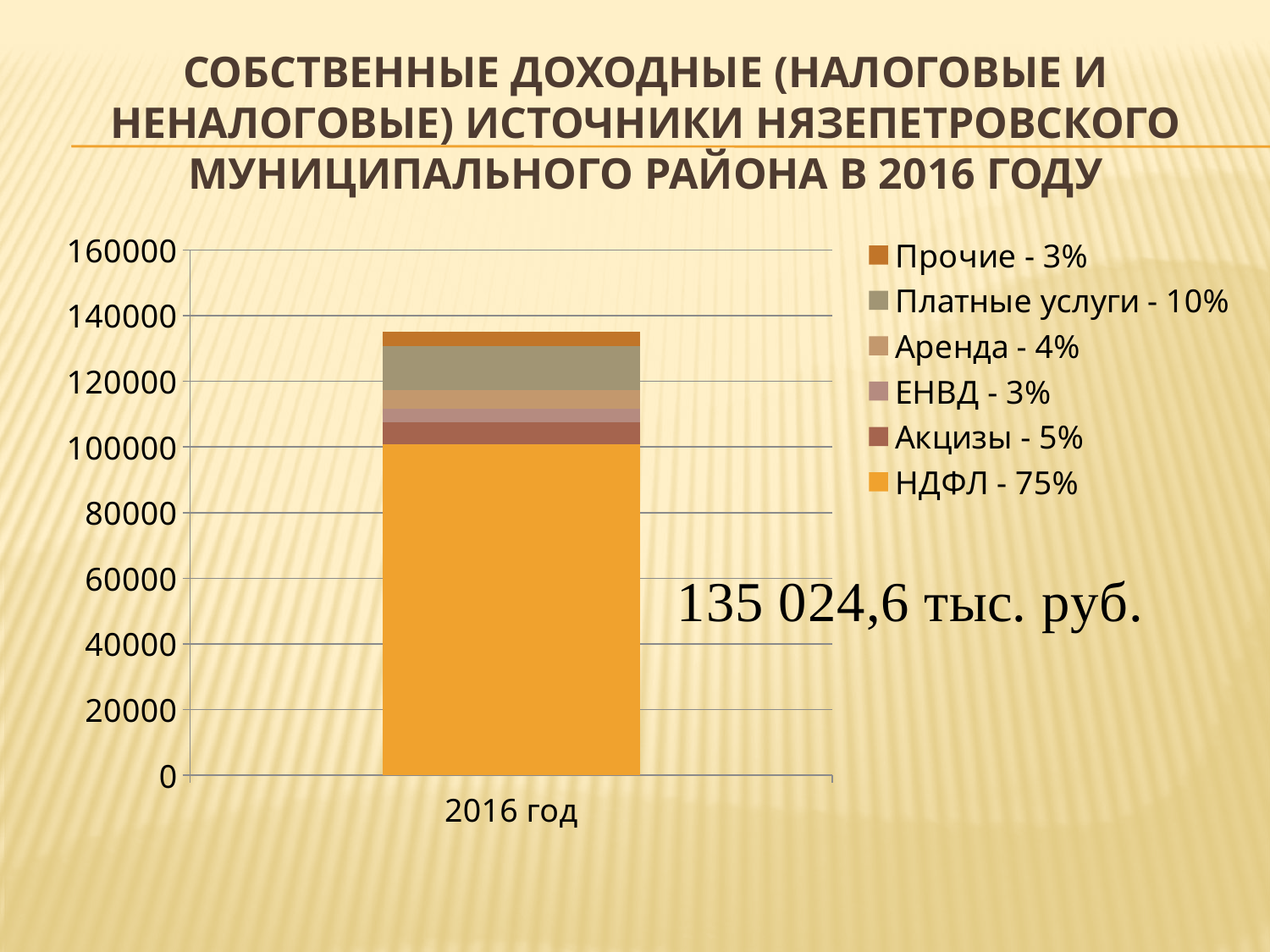
Is the total height of the stacked bar for 2016 год greater or less than 120000? greater What total value is printed next to the bar? 135 024,6 тыс. руб. How many series does the legend list? 6 Is the НДФЛ segment of the bar greater or less than 80000? greater How many categories are shown on the x axis? 1 By how many percentage points does the share of НДФЛ exceed the share of Платные услуги? 65% What share does НДФЛ have according to the legend? 75% Which is larger according to the legend: Платные услуги or Аренда? Платные услуги What share does Платные услуги have according to the legend? 10% Which series makes up the largest part of the stacked bar? НДФЛ - 75% What is the category label on the x axis? 2016 год What kind of chart is shown on the slide? stacked bar chart